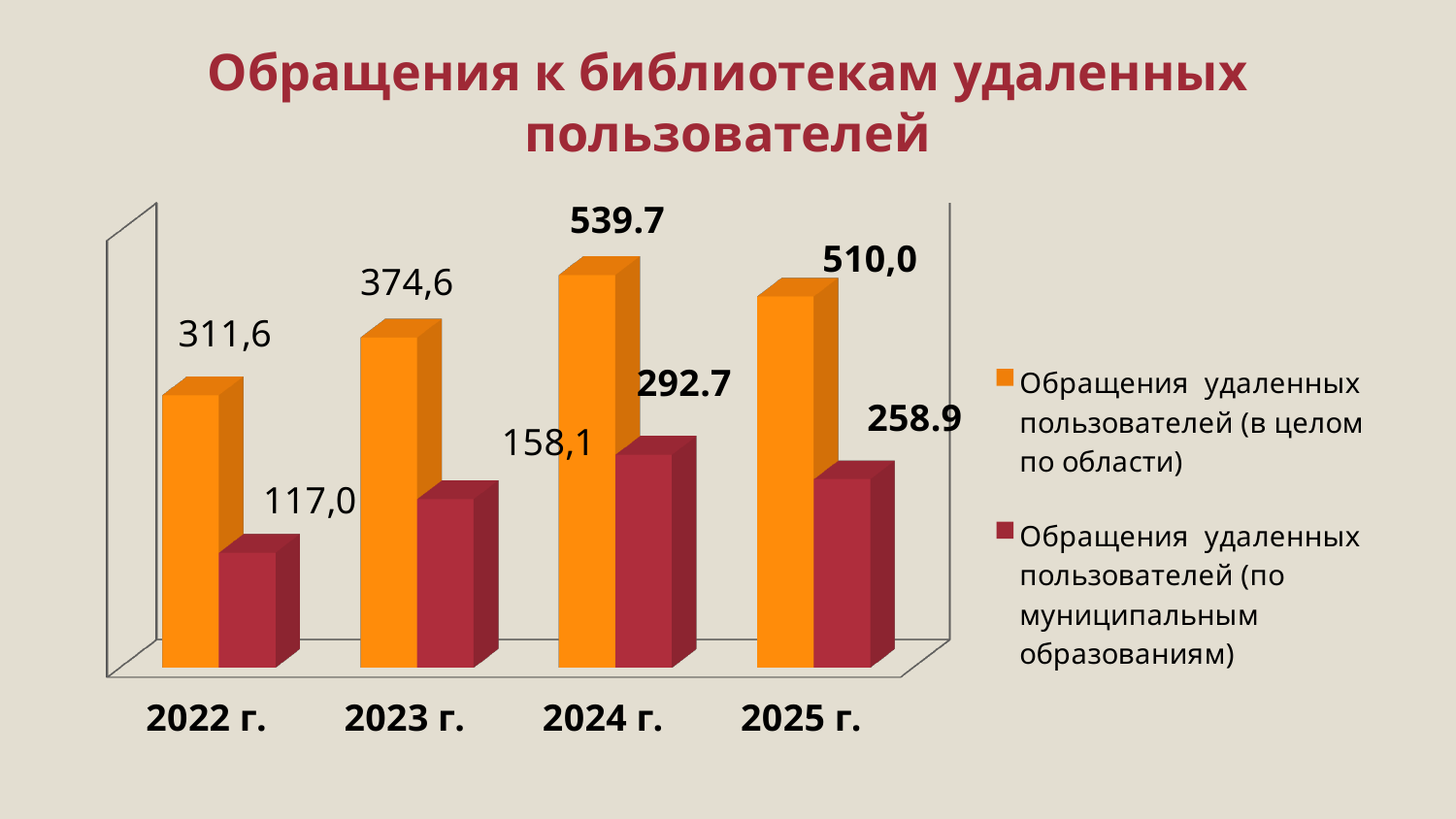
What is the difference between the two series' values in 2024 г.? 247.0 What is the value for 2023 г. for the series 'Обращения удаленных пользователей (по муниципальным образованиям)'? 158,1 How many series does the legend list? 2 How many years are shown on the x axis? 4 What is the value for 2024 г. for the series 'Обращения удаленных пользователей (в целом по области)'? 539.7 In which year is the value for 'Обращения удаленных пользователей (в целом по области)' the highest? 2024 г. What type of chart is shown on the slide? bar chart Which is larger: the 'в целом по области' value for 2024 г. or for 2025 г.? 2024 г. What is the title of the chart? Обращения к библиотекам удаленных пользователей What is the value for 2022 г. for the series 'Обращения удаленных пользователей (в целом по области)'? 311,6 What is the value for 2025 г. for the series 'Обращения удаленных пользователей (по муниципальным образованиям)'? 258.9 In which year is the value for 'Обращения удаленных пользователей (по муниципальным образованиям)' the lowest? 2022 г.